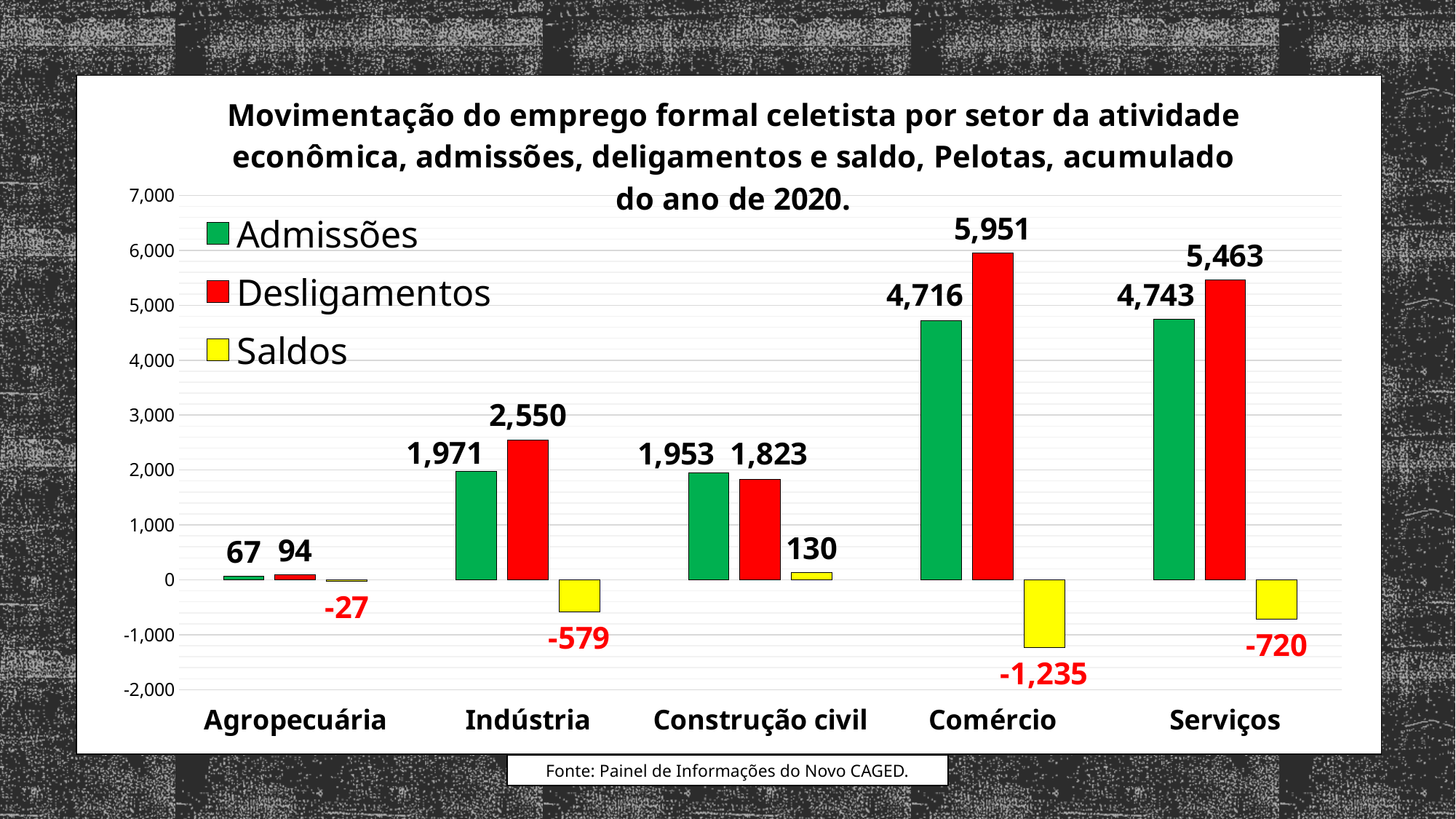
How many sectors are shown on the x axis? 5 Which sector has the lowest Admissões value? Agropecuária Is the Admissões value for Serviços greater or less than 4,000? greater What is the Desligamentos value for Indústria? 2,550 What is the Saldos value for Serviços? -720 What kind of chart is shown on the slide? bar chart Which sector has the highest Desligamentos value? Comércio What is the difference between Desligamentos and Admissões for Serviços? 720 What is the Admissões value for Comércio? 4,716 Which colour represents the Saldos series in the legend? yellow Which is larger for Construção civil, Admissões or Desligamentos? Admissões How many series does the legend list? 3